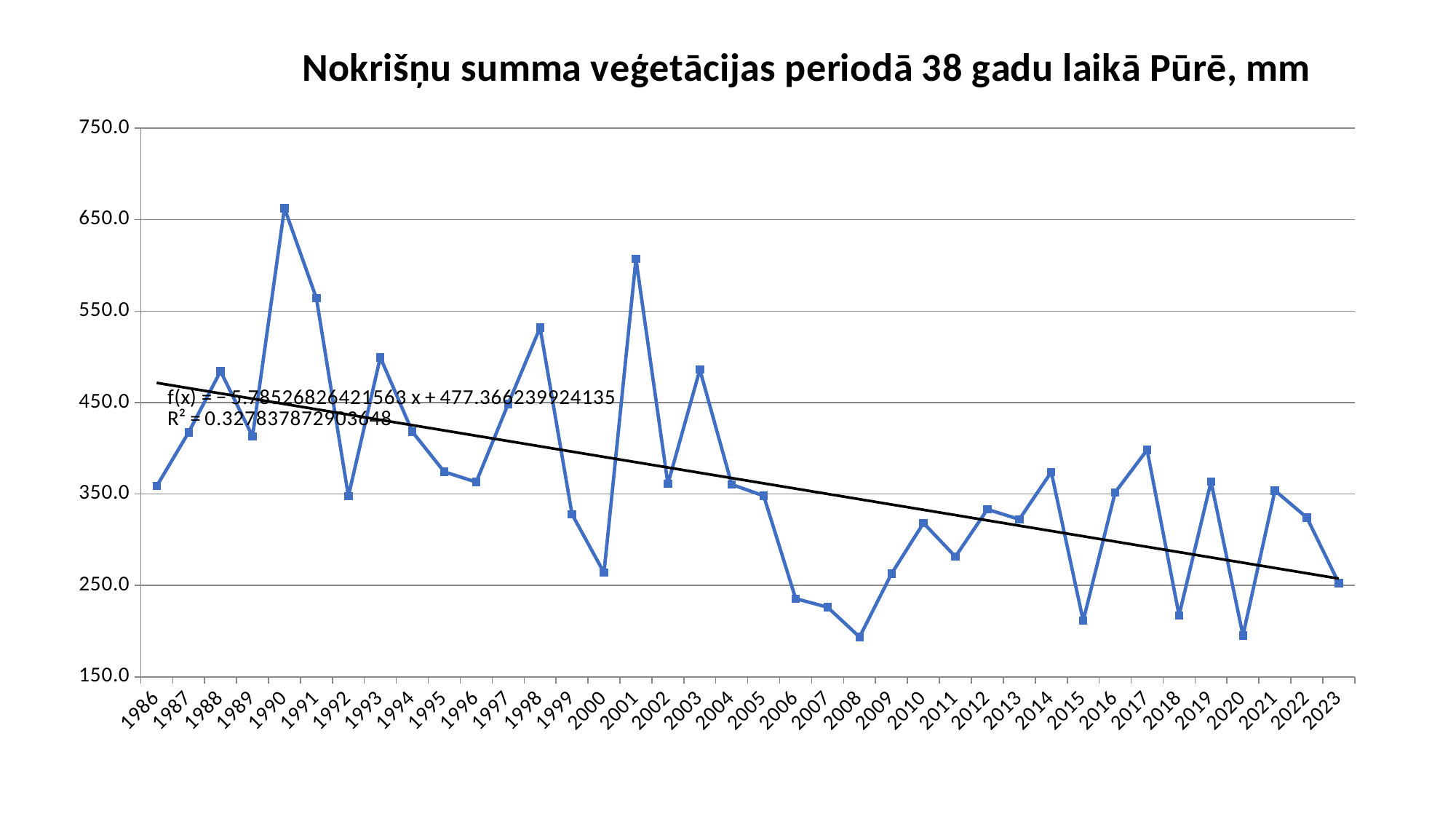
Which year has the larger value, 2008 or 2009? 2009 According to the trendline, do the values generally rise or fall from 1986 to 2023? fall Is the value for 2000 greater or less than 350? less Which year has the highest precipitation value on the chart? 1990 What kind of chart is shown on the slide? line chart What is the title of the chart? Nokrišņu summa veģetācijas periodā 38 gadu laikā Pūrē, mm Which year has the larger value, 1990 or 2001? 1990 Is the value for 1998 greater or less than 450? greater Is the value for 2008 greater or less than 250? less How many years (data points) are plotted on the chart? 38